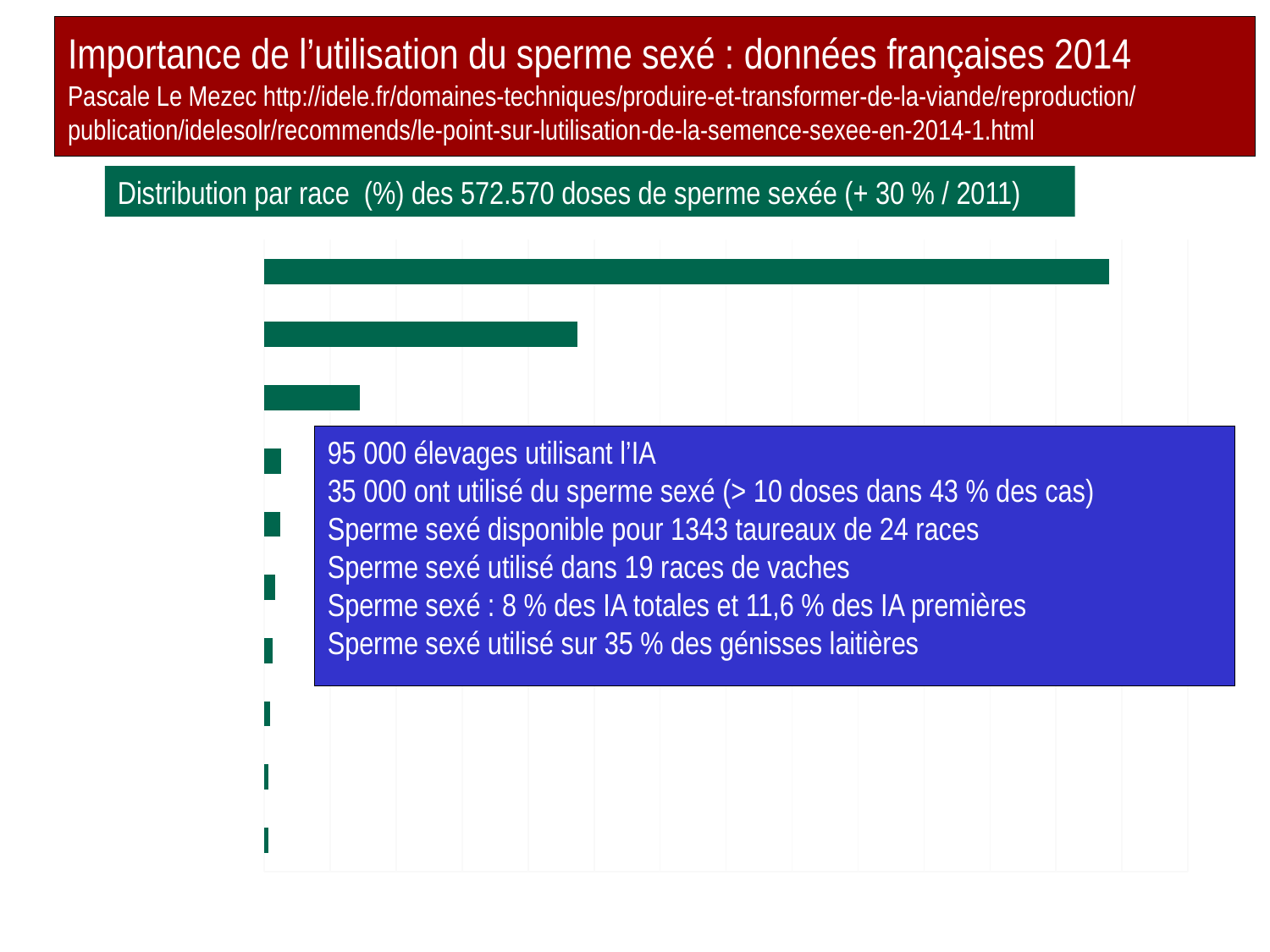
Which is larger, the top bar or the second bar from the top? the top bar Which bar in the chart is the longest? the top bar Which bar in the chart is the shortest? the bottom bar Do the bar lengths increase or decrease going from the top of the chart to the bottom? decrease What is the title of the chart? Distribution par race (%) des 572.570 doses de sperme sexée (+ 30 % / 2011) How many bars does the chart contain? 10 What kind of chart is shown on the slide? bar chart What colour are the bars in the chart? dark green